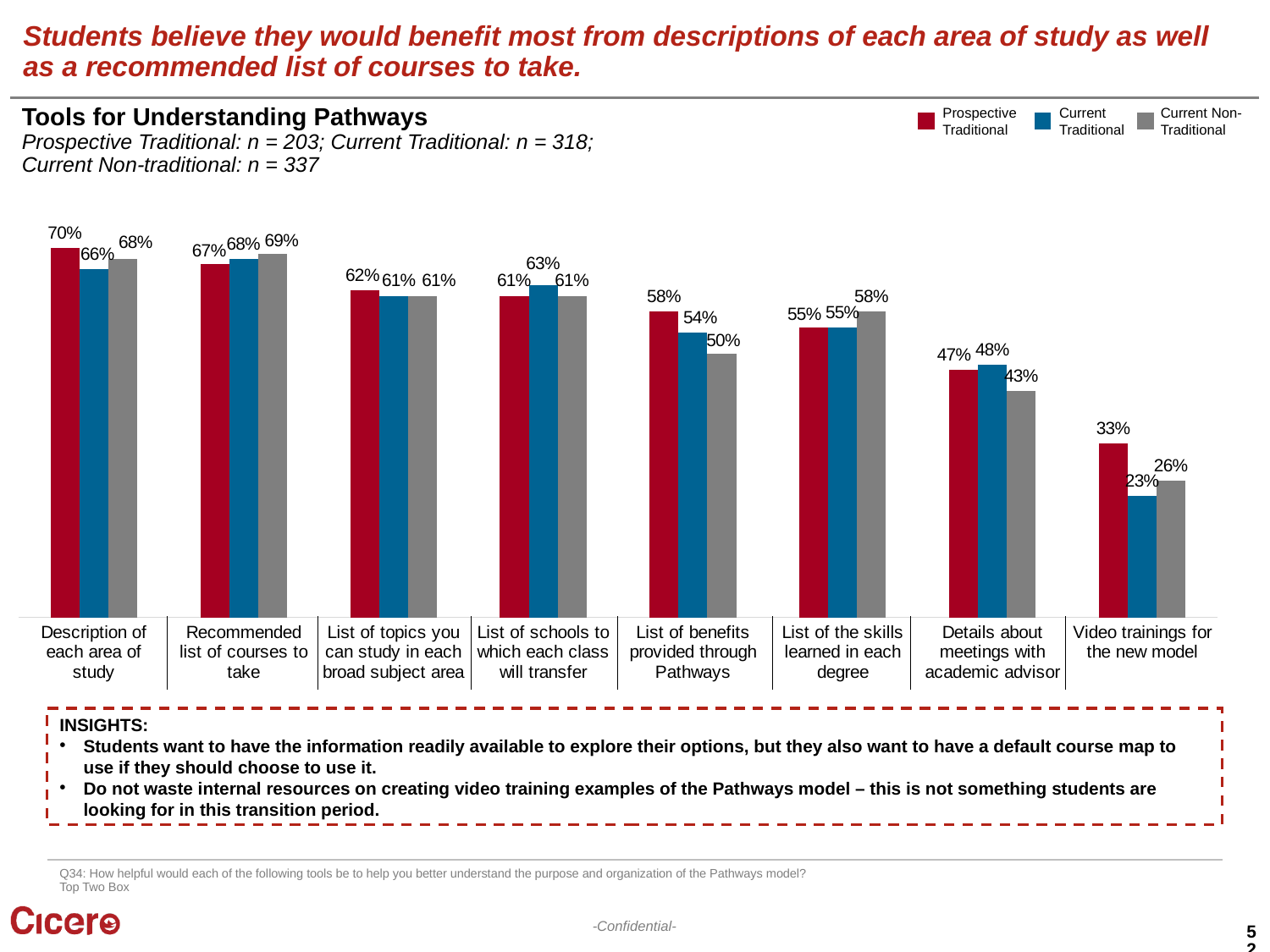
Do the Prospective Traditional values generally rise or fall from left to right across the categories? Fall For "List of the skills learned in each degree", which is larger: the Current Traditional value or the Current Non-Traditional value? Current Non-Traditional What is the Current Non-Traditional value for "Details about meetings with academic advisor"? 43% How many categories are shown on the x axis of the chart? 8 Which category has the lowest Prospective Traditional value? Video trainings for the new model How many series does the legend list? 3 What is the sample size (n) for Current Non-traditional students shown in the chart subtitle? 337 What is the Current Traditional value for "Video trainings for the new model"? 23% What is the Prospective Traditional value for "Description of each area of study"? 70% What kind of chart is shown on the slide? Bar chart Which category has the highest Current Non-Traditional value? Recommended list of courses to take What is the difference between the Prospective Traditional and Current Non-Traditional values for "List of benefits provided through Pathways"? 8%